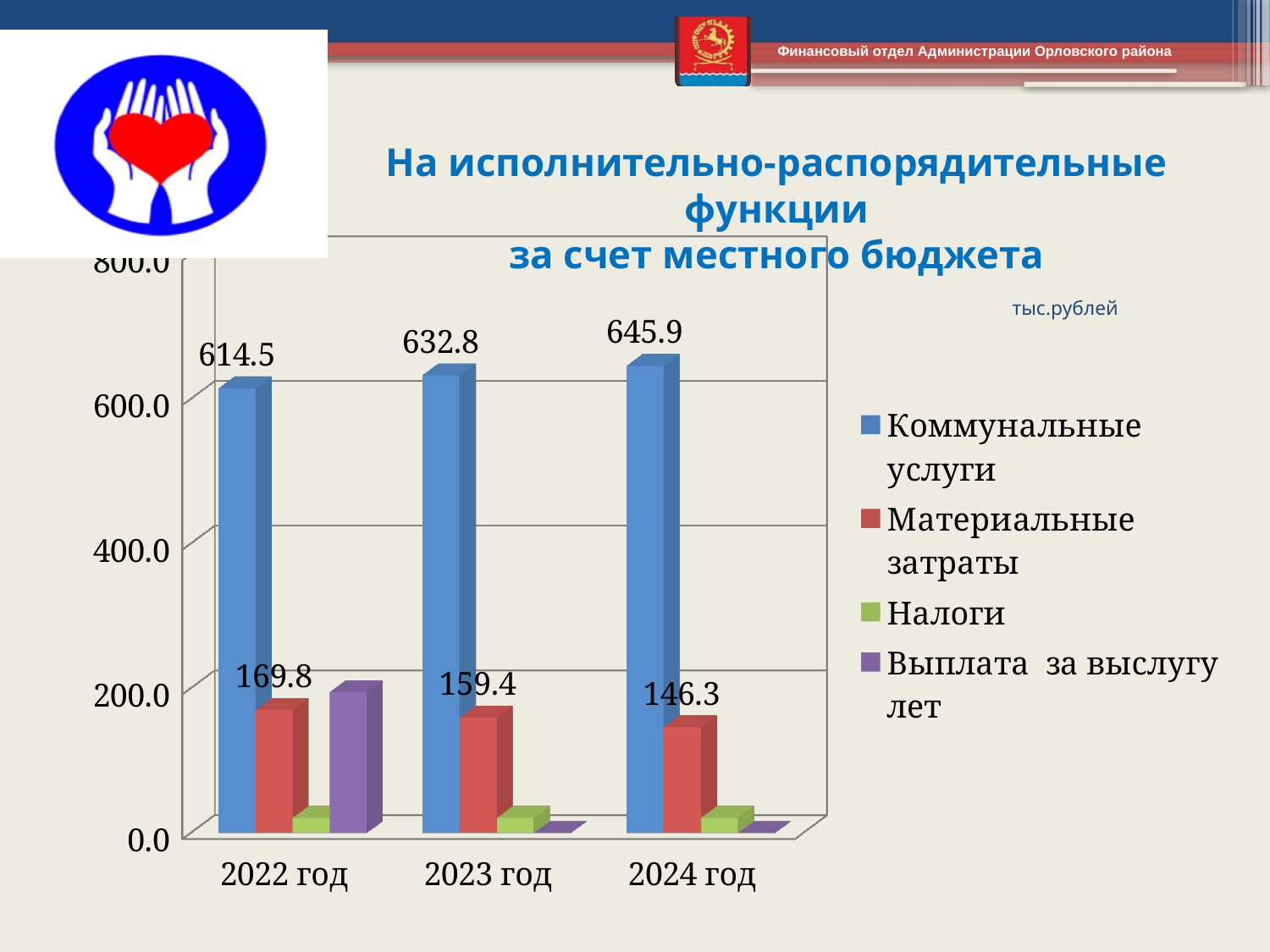
How many series does the legend list? 4 Which is larger: Материальные затраты in 2022 год or in 2023 год? 2022 год In which year is the value for Материальные затраты the lowest? 2024 год How does the value for Коммунальные услуги change from 2022 год to 2024 год? It rises In which year is the value for Коммунальные услуги the highest? 2024 год What is the difference between the Коммунальные услуги values for 2024 год and 2022 год? 31.4 What is the value for Коммунальные услуги in 2022 год? 614.5 What is the value for Материальные затраты in 2023 год? 159.4 What kind of chart is shown on the slide? Bar chart Is the value for Выплата за выслугу лет in 2022 год greater or less than 400.0? less What is the value for Коммунальные услуги in 2024 год? 645.9 What is the value for Материальные затраты in 2024 год? 146.3